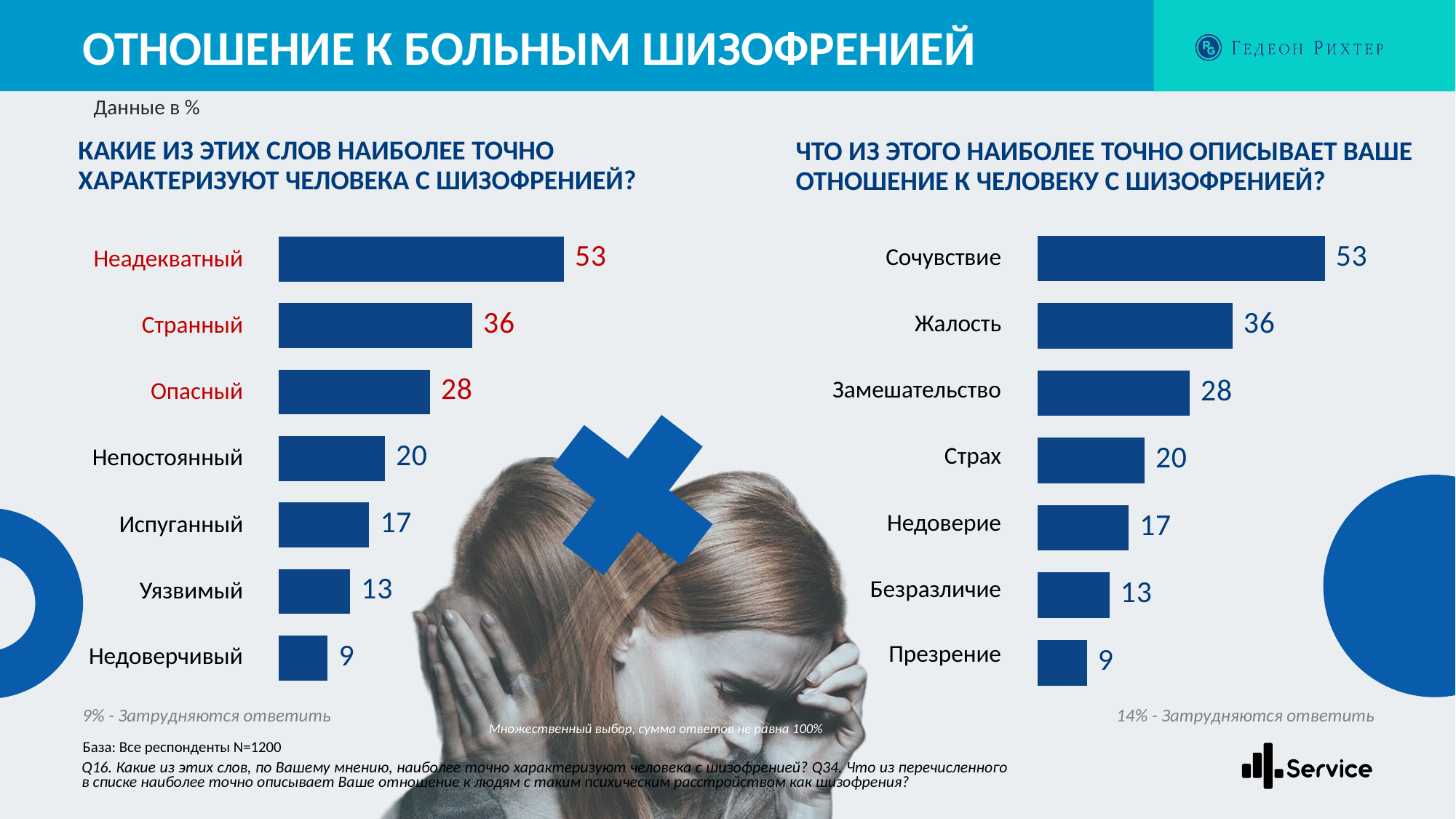
On the left chart, which category has the highest value? Неадекватный On the right chart, what is the value for Презрение? 9 On the left chart, what is the difference between the values for Странный and Опасный? 8 On the left chart, do the values rise or fall going from the top category to the bottom category? Fall What type of chart is used on the right side of the slide? Bar chart On the left chart, what is the value for Уязвимый? 13 On the left chart ("Какие из этих слов наиболее точно характеризуют человека с шизофренией?"), what is the value for Неадекватный? 53 On the right chart, what is the difference between the values for Сочувствие and Страх? 33 On the right chart, which is larger: Недоверие or Безразличие? Недоверие On the right chart, which category has the lowest value? Презрение How many categories are shown on the left chart? 7 On the right chart ("Что из этого наиболее точно описывает ваше отношение к человеку с шизофренией?"), what is the value for Замешательство? 28